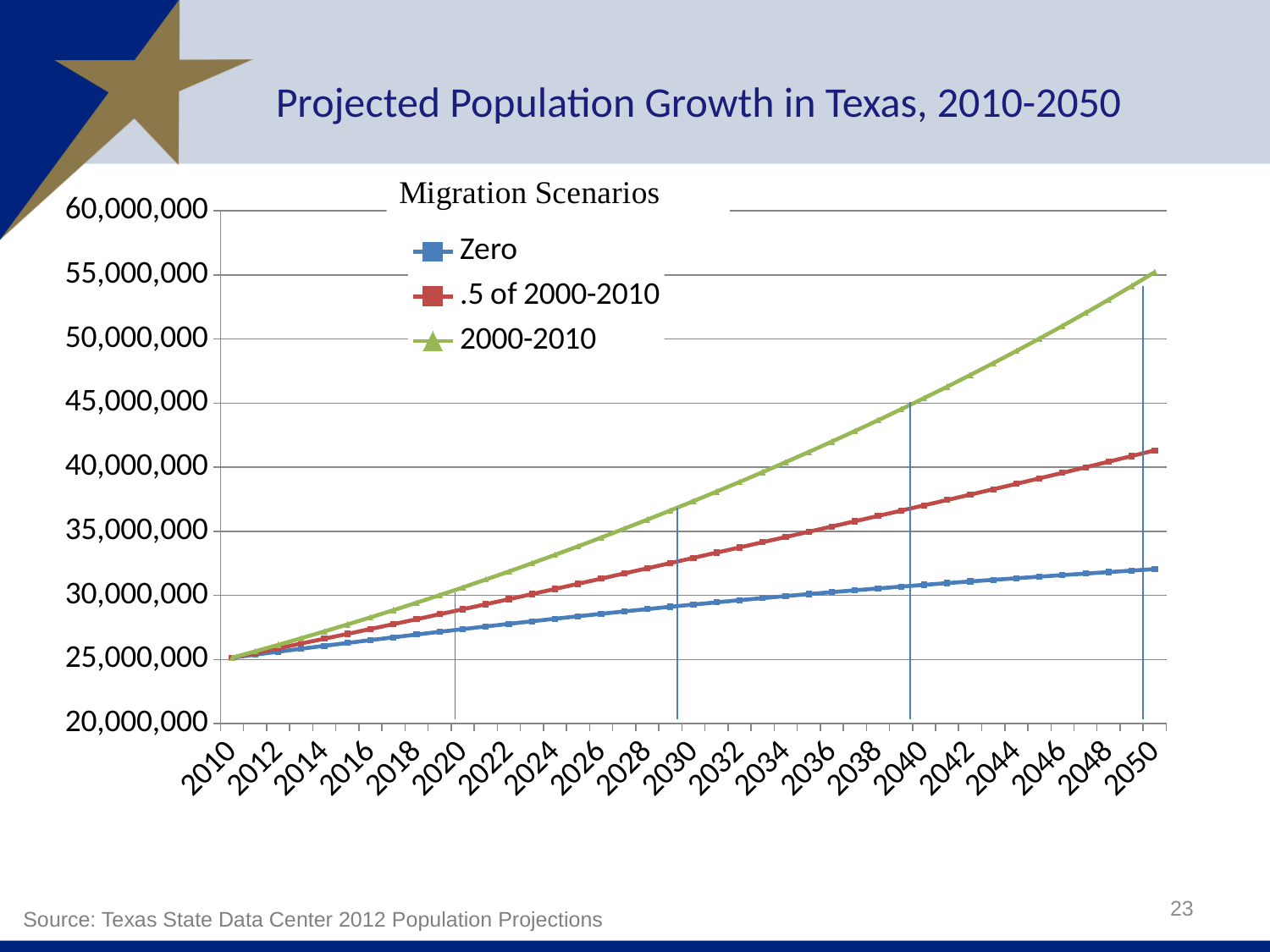
Which migration scenario has the highest projected population in 2050? 2000-2010 Is the projected population for the 2000-2010 scenario in 2030 greater or less than 35,000,000? greater Is the projected population for the Zero scenario in 2030 greater or less than 30,000,000? less What kind of chart is shown on the slide? line chart Is the projected population for the .5 of 2000-2010 scenario in 2040 greater or less than 35,000,000? greater What are the three migration scenarios listed in the legend? Zero, .5 of 2000-2010, 2000-2010 In 2040, which is larger: the projected population under the Zero scenario or under the .5 of 2000-2010 scenario? .5 of 2000-2010 What is the title of the chart? Projected Population Growth in Texas, 2010-2050 How many series does the legend list? 3 Do the values for the 2000-2010 scenario rise or fall from 2010 to 2050? rise Which migration scenario has the lowest projected population in 2050? Zero